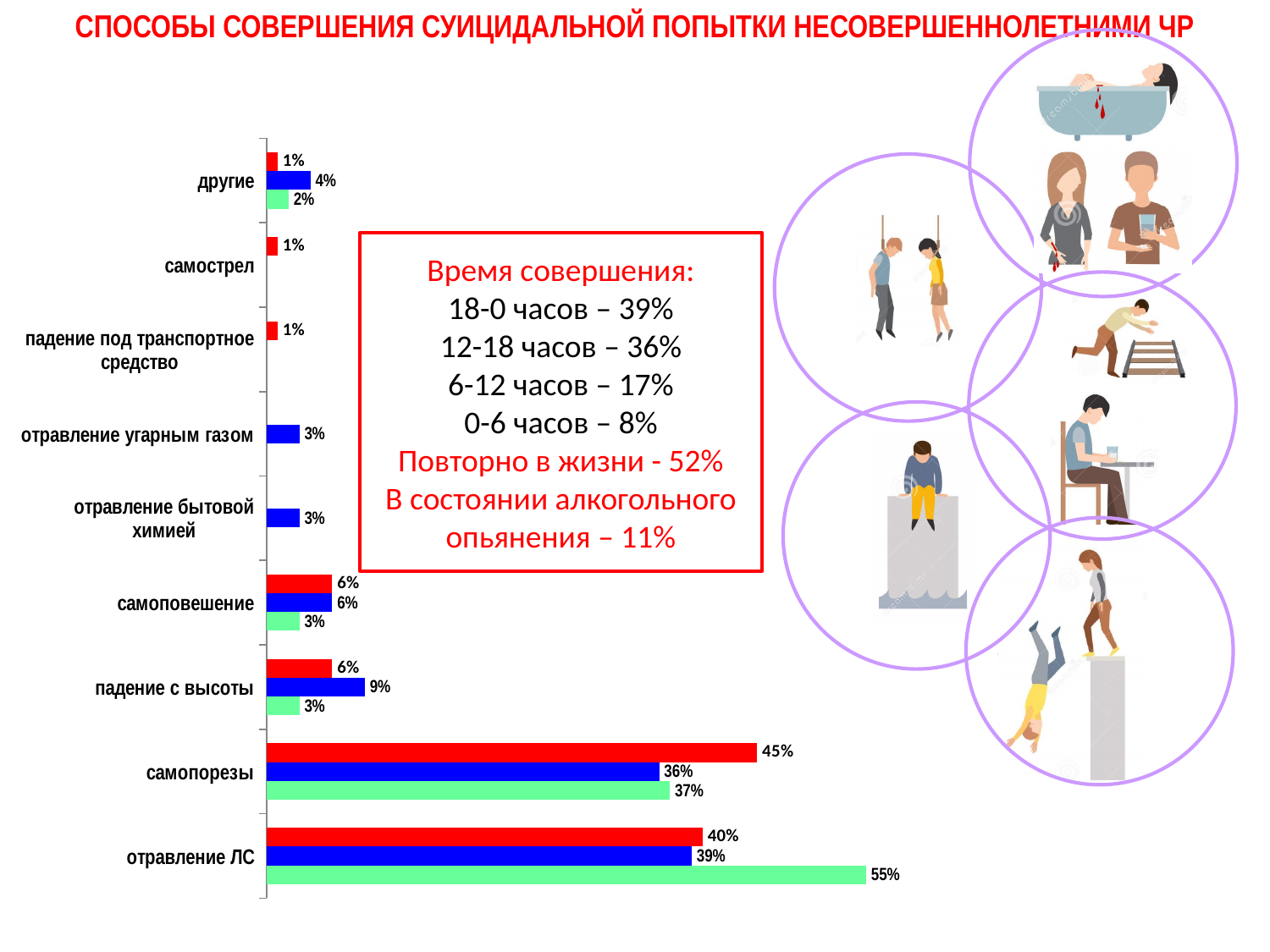
What is the value of the blue bar for падение с высоты? 9% What is the value of the green bar for отравление ЛС? 55% What type of chart is shown on the slide? bar chart What is the value of the red bar for самопорезы? 45% What is the value of the blue bar for другие? 4% How many categories are listed on the vertical axis of the bar chart? 9 Which category has the highest green bar? отравление ЛС Which is larger: the green bar for самопорезы or the green bar for самоповешение? самопорезы What is the difference between the red bar and the blue bar for самопорезы? 9% Which category has the highest red bar? самопорезы What is the value of the red bar for самострел? 1% What is the title of the slide? СПОСОБЫ СОВЕРШЕНИЯ СУИЦИДАЛЬНОЙ ПОПЫТКИ НЕСОВЕРШЕННОЛЕТНИМИ ЧР